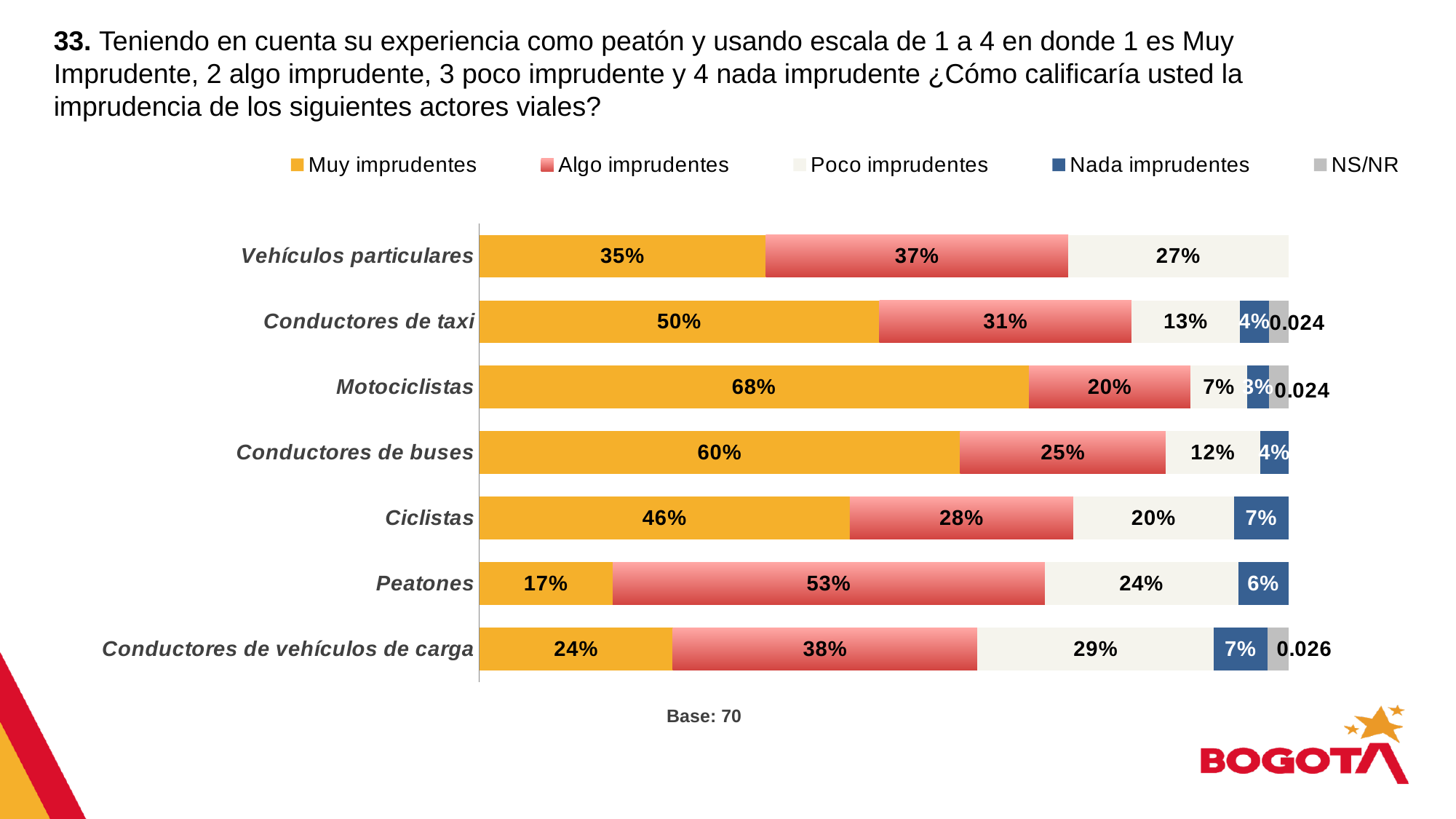
Which road actor has the lowest Muy imprudentes percentage? Peatones What is the base (number of respondents) noted below the chart? 70 What is the Algo imprudentes value for Peatones? 53% What is the Poco imprudentes value for Conductores de vehículos de carga? 29% What is the Nada imprudentes value for Ciclistas? 7% How many road actor categories are shown in the chart? 7 What is the difference in percentage points between the Muy imprudentes value for Motociclistas and for Peatones? 51 Which road actor has the highest Muy imprudentes percentage? Motociclistas Which has a larger Algo imprudentes value: Peatones or Vehículos particulares? Peatones How many series does the legend list? 5 What percentage of respondents rated Motociclistas as Muy imprudentes? 68% What type of chart is shown on the slide? Stacked bar chart